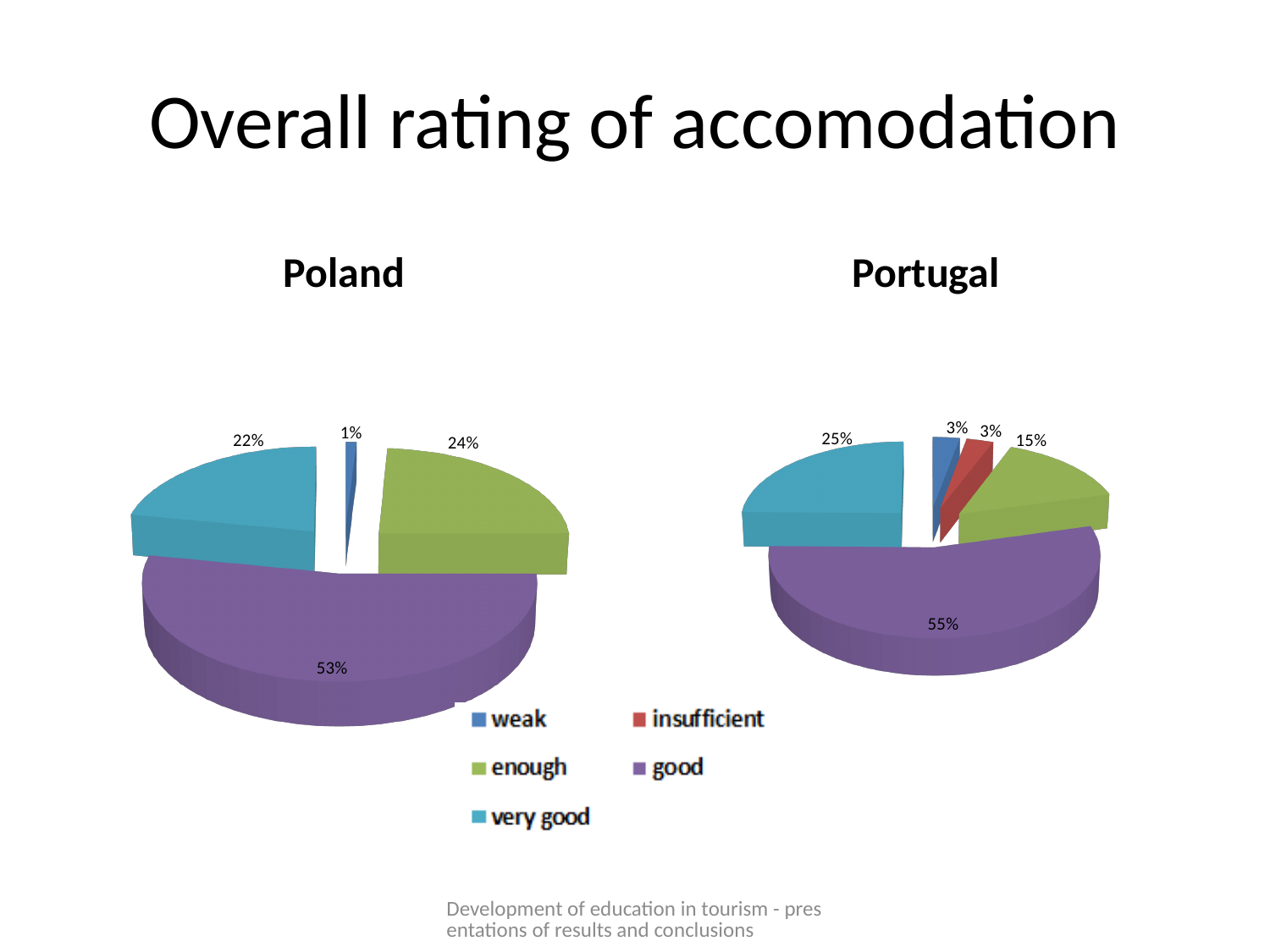
Which is larger: the 'very good' share in Poland or the 'very good' share in Portugal? Portugal What colour represents the 'insufficient' rating in the legend? red In the Portugal chart, what percentage is shown for the 'enough' rating? 15% What type of chart is used for Poland and Portugal on this slide? pie chart In the Poland chart, which rating has the largest slice? good In the Portugal chart, what share of respondents rated accommodation as very good? 25% In the Portugal chart, which rating has the largest slice? good How many rating categories does the legend list? 5 In the Poland chart, what percentage is shown for the 'enough' rating? 24% What is the difference between the 'good' share in Portugal and the 'good' share in Poland? 2% In the Poland chart, which rating has the smallest slice? weak In the Poland chart, what share of respondents rated accommodation as good? 53%